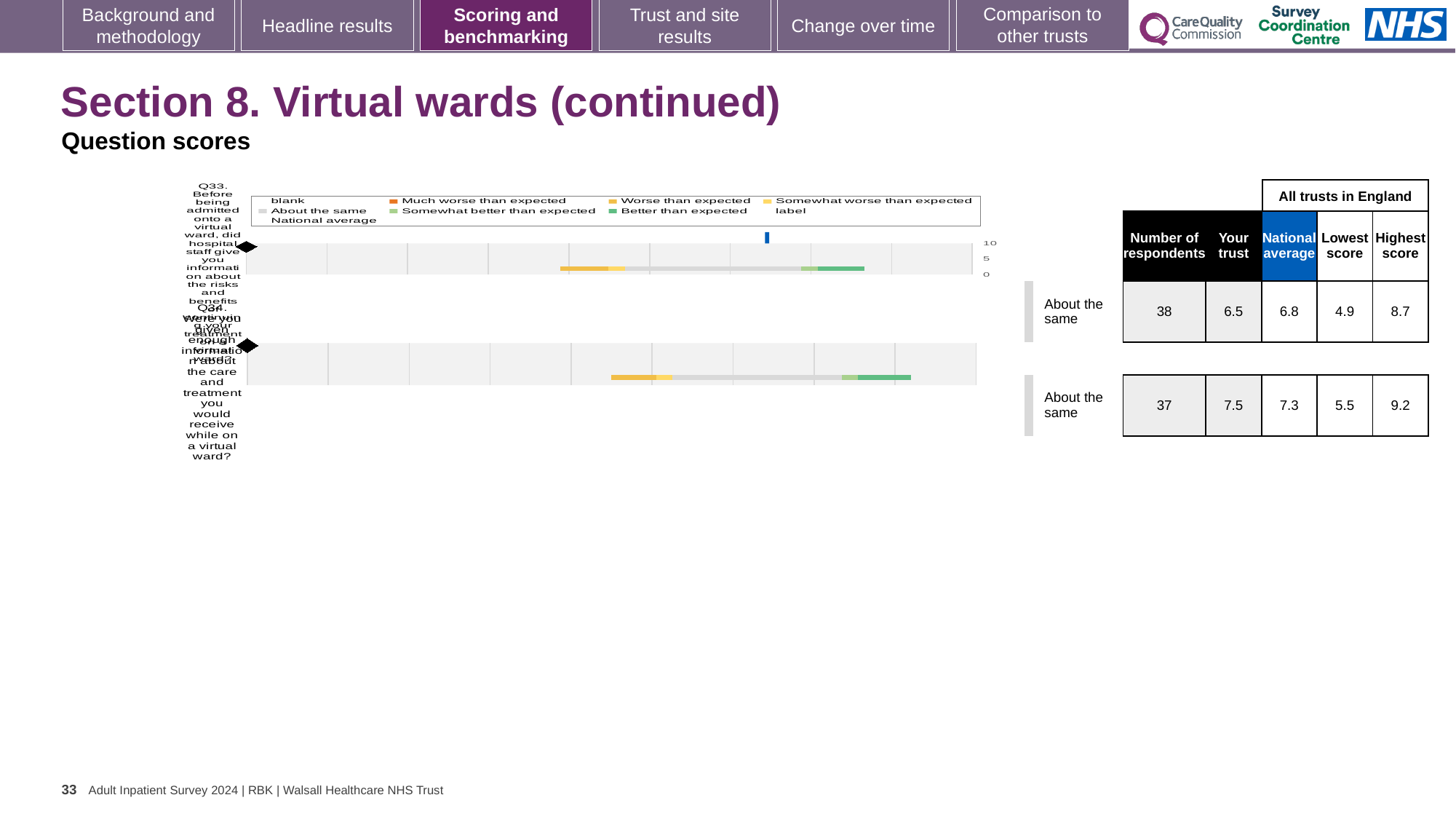
What is the 'Your trust' score for Q34 (enough information about care and treatment on a virtual ward)? 7.5 What benchmark category is shown for Q33 and Q34? About the same How many respondents answered Q33? 38 How many questions (bars) are plotted in the chart? 2 What is the 'Your trust' score for Q33 (information about the risks and benefits of a virtual ward)? 6.5 For Q34, which is larger: the 'Your trust' score or the national average? Your trust What is the highest score among all trusts in England for Q34? 9.2 What is the lowest score among all trusts in England for Q33? 4.9 What is the difference between the highest and lowest scores for Q34? 3.7 What kind of chart is shown on the slide? bar chart What is the national average score for Q33? 6.8 What is the difference between the national average and the 'Your trust' score for Q33? 0.3